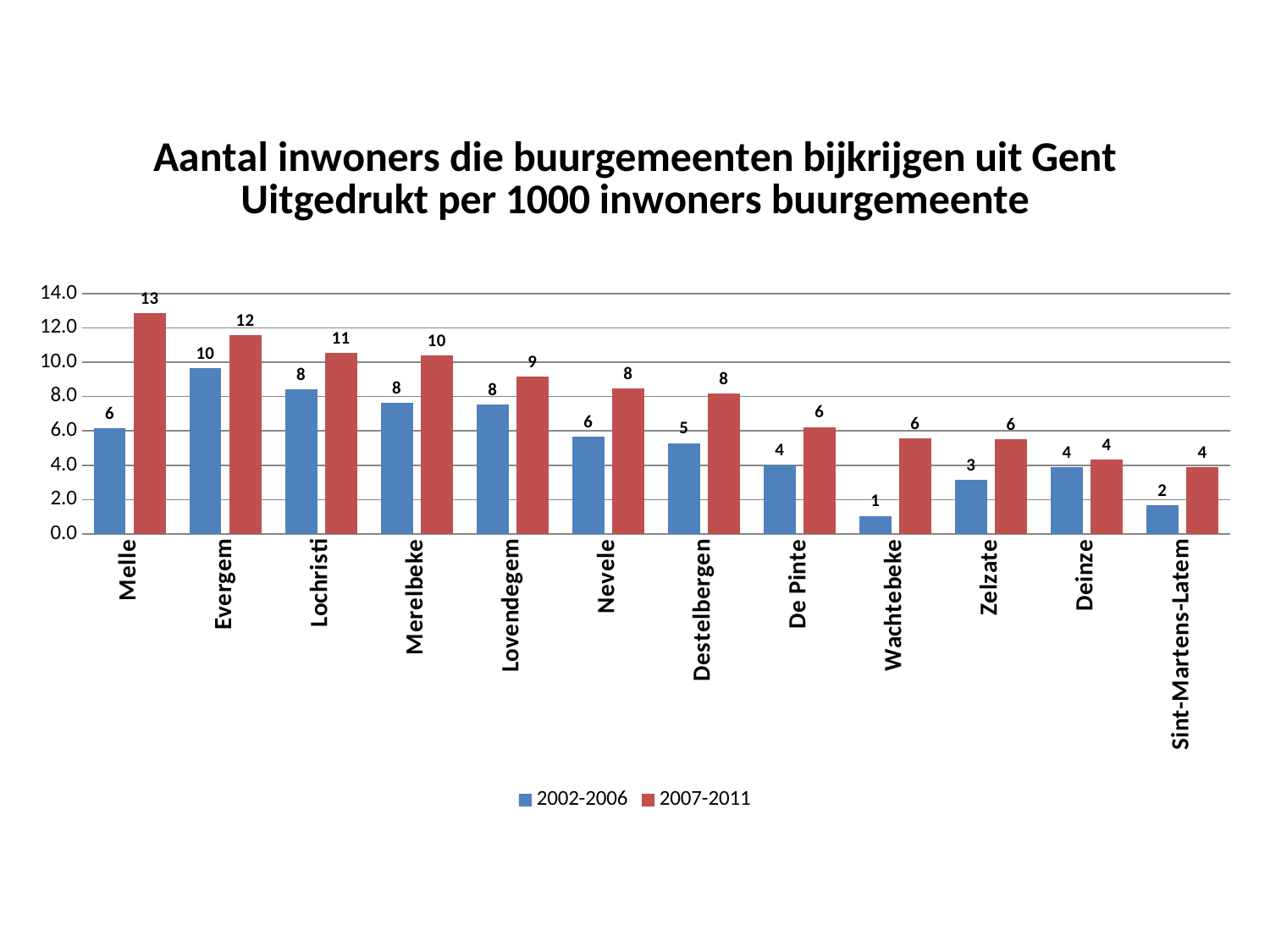
How many series does the legend list? 2 What is the value for Melle in the 2007-2011 series? 13 Which municipality has the highest value in the 2007-2011 series? Melle What is the value for Wachtebeke in the 2002-2006 series? 1 Which municipality has the lowest value in the 2002-2006 series? Wachtebeke Which is larger: the 2007-2011 value for Melle or the 2007-2011 value for Evergem? Melle Is the 2002-2006 value for Evergem greater or less than 8.0? greater How many municipalities are shown on the x axis? 12 What is the difference between the 2007-2011 and 2002-2006 values for Melle? 7 Which colour represents the 2007-2011 series? red Do the 2007-2011 values generally rise or fall from left to right along the x axis? fall What kind of chart is shown on the slide? bar chart